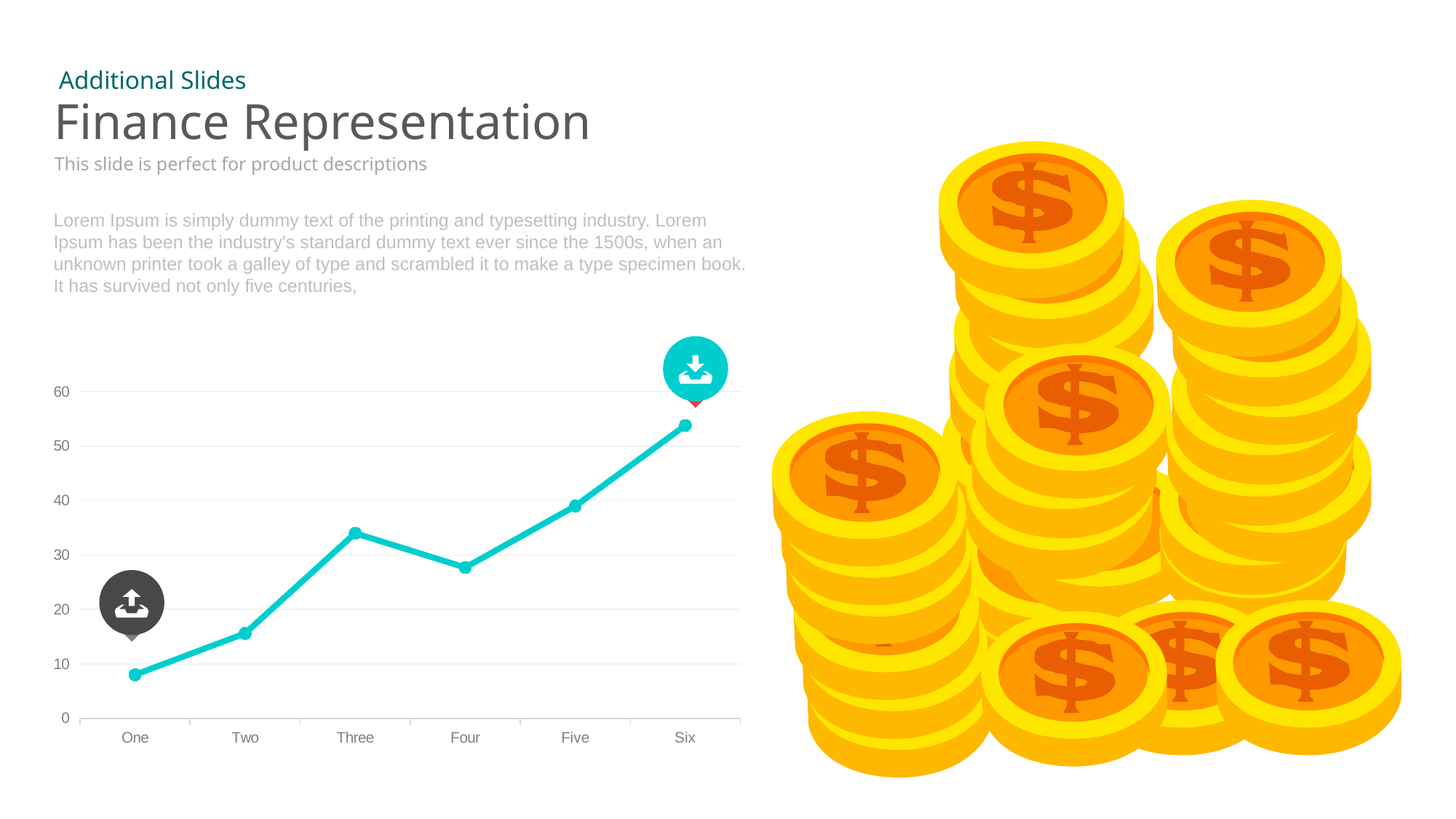
What is the highest value shown on the chart's vertical axis? 60 Which category has the lowest value in the chart? One What kind of chart is shown on the slide? line chart Which category has the highest value in the chart? Six Is the value for Three greater or less than 30? greater How many categories are plotted along the x axis of the chart? 6 Is the value for Five greater or less than 30? greater Is the value for Six greater or less than 50? greater Which has the larger value, Three or Four? Three Do the values generally rise or fall from One to Six? rise